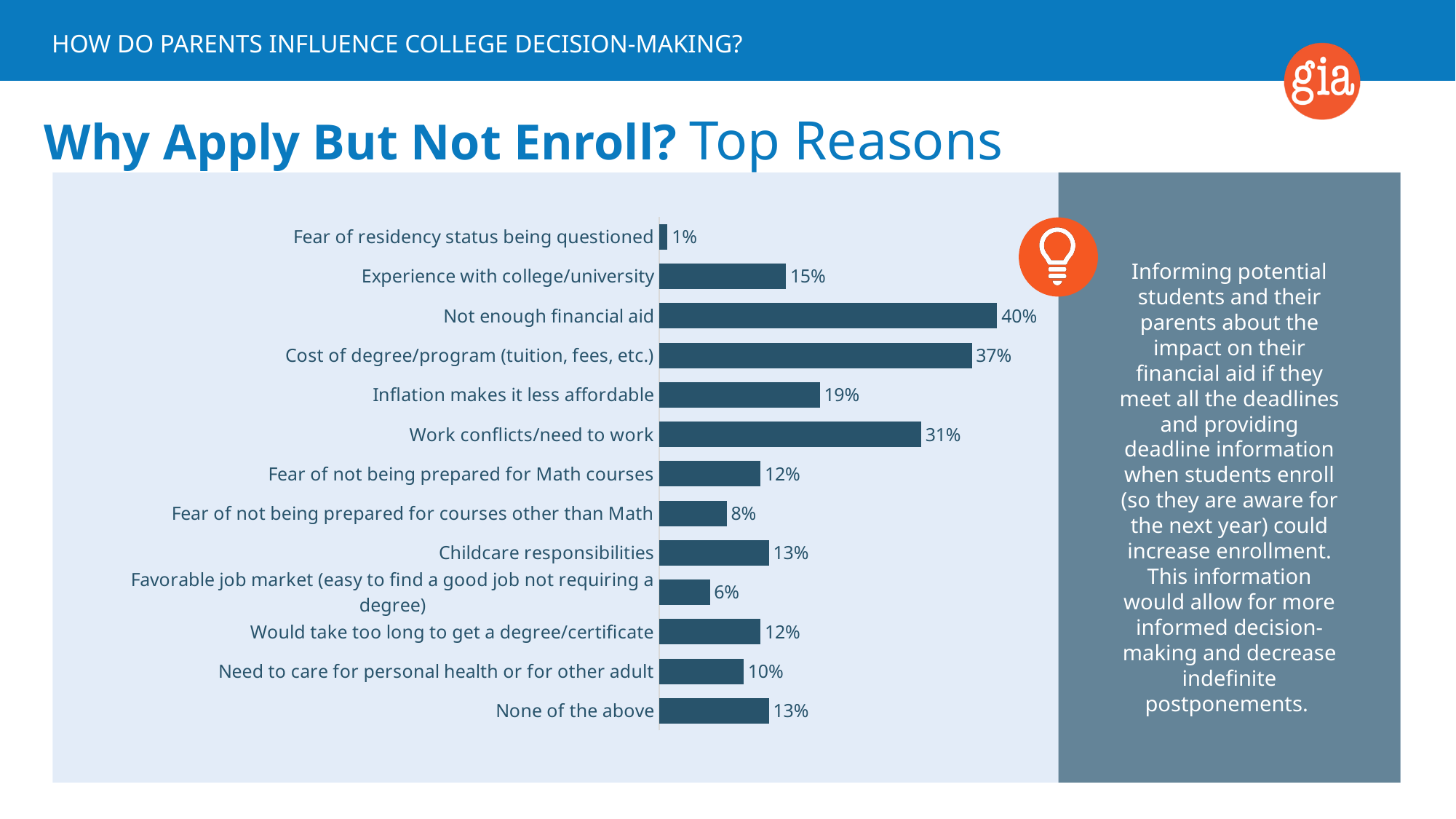
How many reasons (categories) are plotted in the chart? 13 Which reason has the highest percentage? Not enough financial aid What percentage is shown for "Not enough financial aid"? 40% Which reason has the lowest percentage? Fear of residency status being questioned What is the difference between "Inflation makes it less affordable" and "Experience with college/university"? 4% What is the title of the slide containing the chart? Why Apply But Not Enroll? Top Reasons What percentage is shown for "Fear of residency status being questioned"? 1% What is the difference between "Not enough financial aid" and "Cost of degree/program (tuition, fees, etc.)"? 3% What is the value for "Work conflicts/need to work"? 31% What kind of chart is shown on the slide? Bar chart Which is larger: "Childcare responsibilities" or "Need to care for personal health or for other adult"? Childcare responsibilities What is the value for "Favorable job market (easy to find a good job not requiring a degree)"? 6%